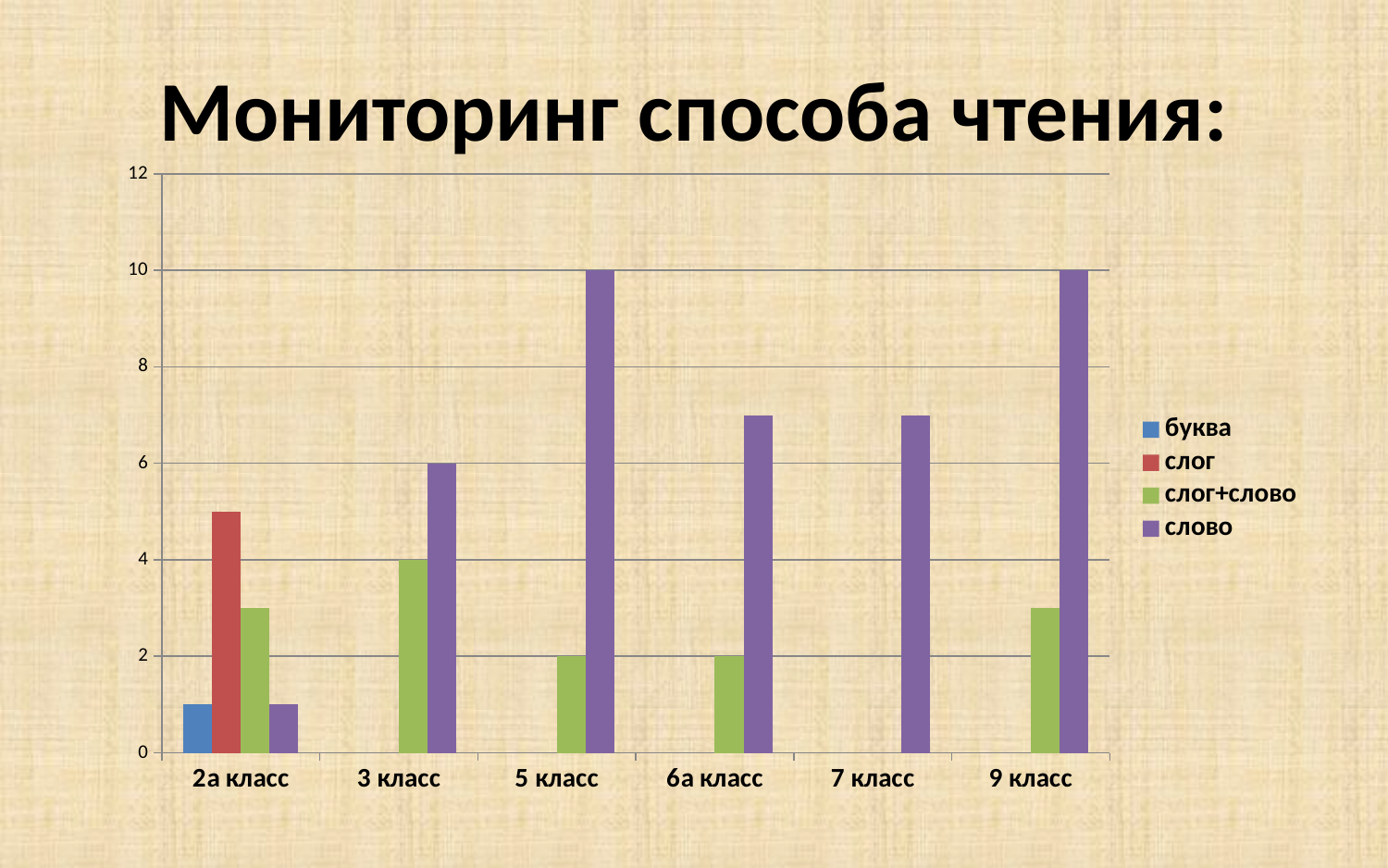
Is the value of 'слог' for 2а класс greater or less than 4? greater Which series has the highest value for 2а класс? слог What is the value of 'слово' for 3 класс? 6 What is the difference between the 'слово' values for 5 класс and 3 класс? 4 What is the value of 'слог+слово' for 6а класс? 2 Is the value of 'слово' for 7 класс greater or less than 8? less What is the value of 'слово' for 5 класс? 10 What is the value of 'слог+слово' for 3 класс? 4 How many classes (categories) are shown on the x axis? 6 What kind of chart is shown on the slide? bar chart Which class has the lowest value for 'слово'? 2а класс How many series does the legend list? 4